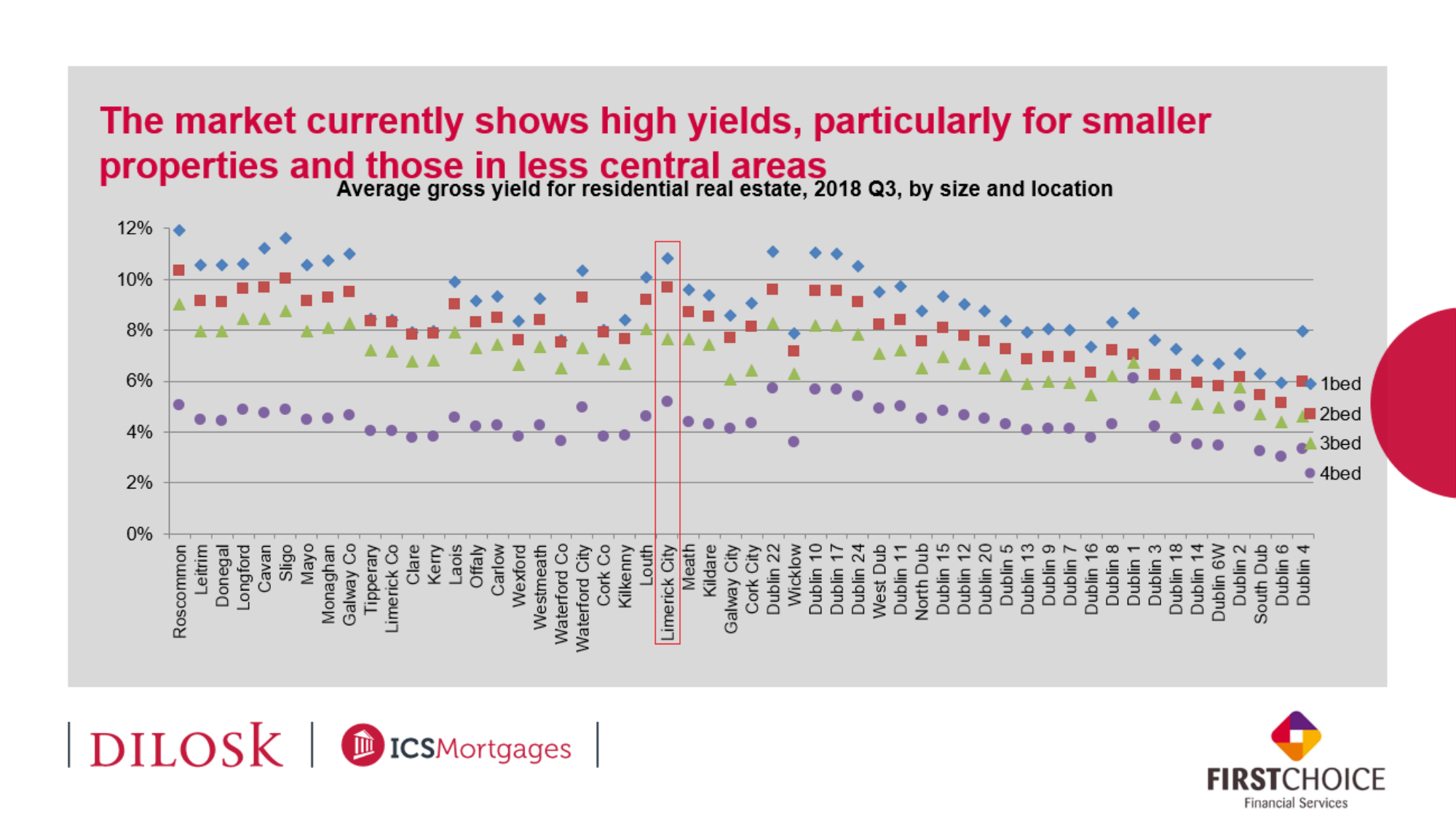
What kind of chart is shown on the slide? Scatter chart Which location has the lowest 4bed yield? Dublin 6 What is the title of the chart? Average gross yield for residential real estate, 2018 Q3, by size and location Which location is highlighted with a red box on the chart? Limerick City Is the 1bed value for Limerick City greater or less than 10%? greater How many series does the legend list? 4 How many locations are plotted along the x axis? 54 Which series generally has the highest yields across locations? 1bed Is the 4bed value for Dublin 4 greater or less than 4%? less Is the 1bed value for Roscommon greater or less than 10%? greater Which is larger, the 1bed value for Roscommon or the 1bed value for Dublin 4? Roscommon